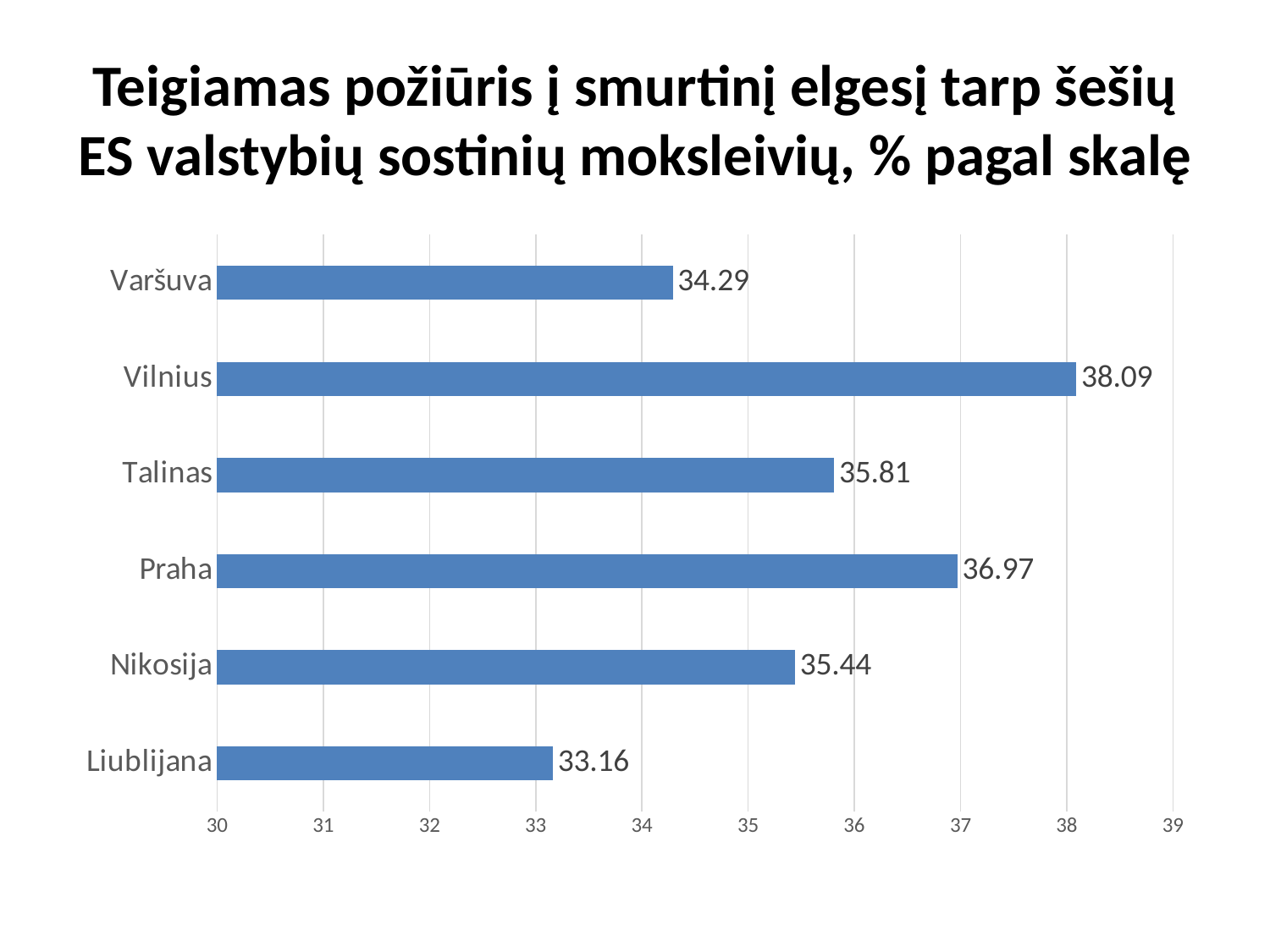
Is the value for Talinas greater or less than 35? greater What is the difference between the values for Vilnius and Liublijana? 4.93 Which city has the highest value? Vilnius Which is larger, the value for Nikosija or the value for Varšuva? Nikosija What is the value for Liublijana? 33.16 How many cities are shown in the chart? 6 What is the difference between the values for Praha and Talinas? 1.16 Which city has the lowest value? Liublijana What is the value for Praha? 36.97 What is the value for Nikosija? 35.44 What is the value for Vilnius? 38.09 What kind of chart is shown on the slide? bar chart